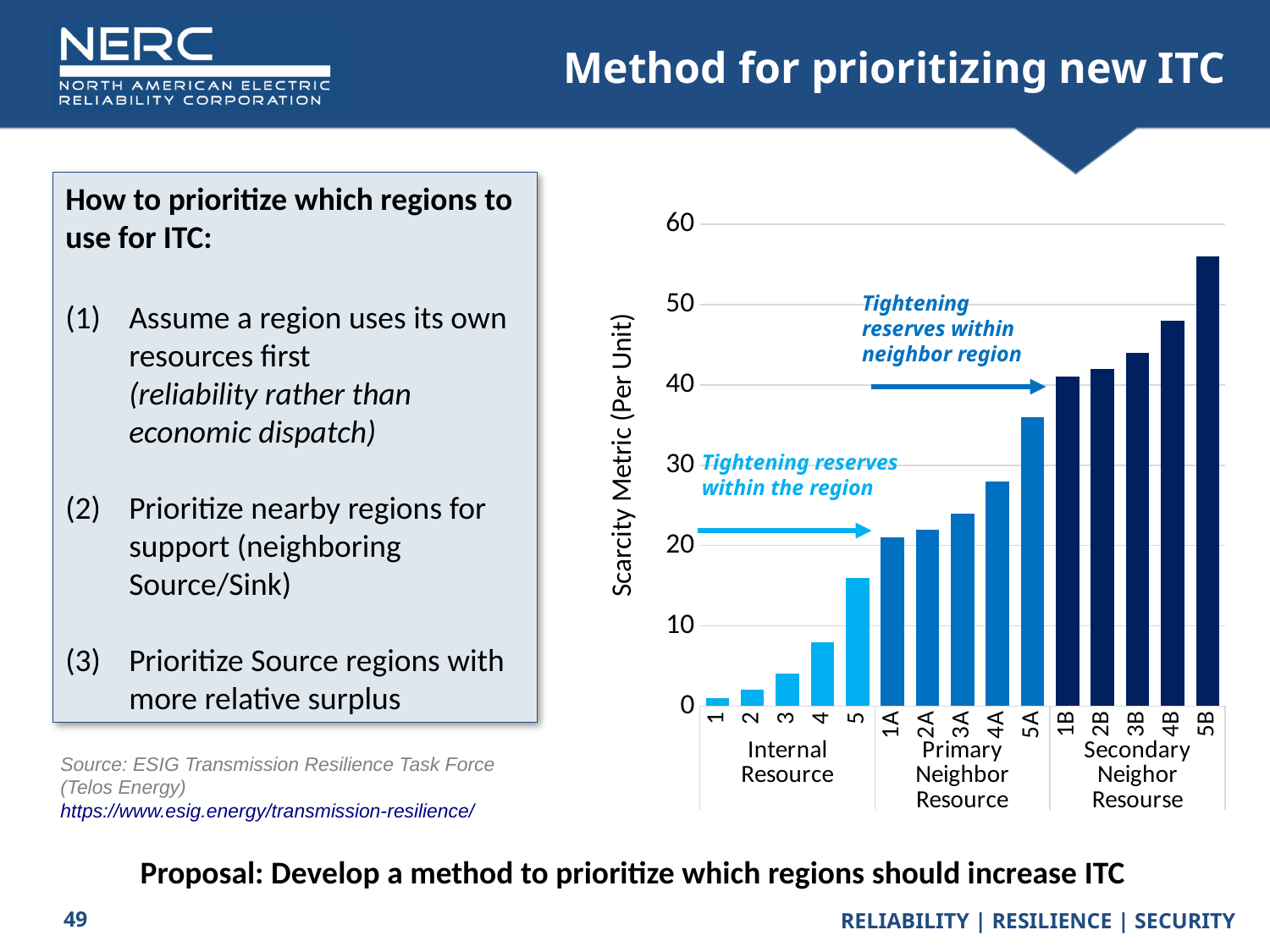
Which has the larger value, 5A or 1A? 5A Which category has the lowest Scarcity Metric value? 1 How many bars are plotted in the chart? 15 Is the value for 5A greater or less than 40? less What is the label of the vertical axis? Scarcity Metric (Per Unit) Is the value for 4B greater or less than 40? greater How many resource groups are labeled along the x axis? 3 Which category has the highest Scarcity Metric value? 5B Is the value for 5 greater or less than 10? greater What kind of chart is shown on the slide? bar chart Do the values rise or fall moving from category 1 to category 5B along the x axis? rise